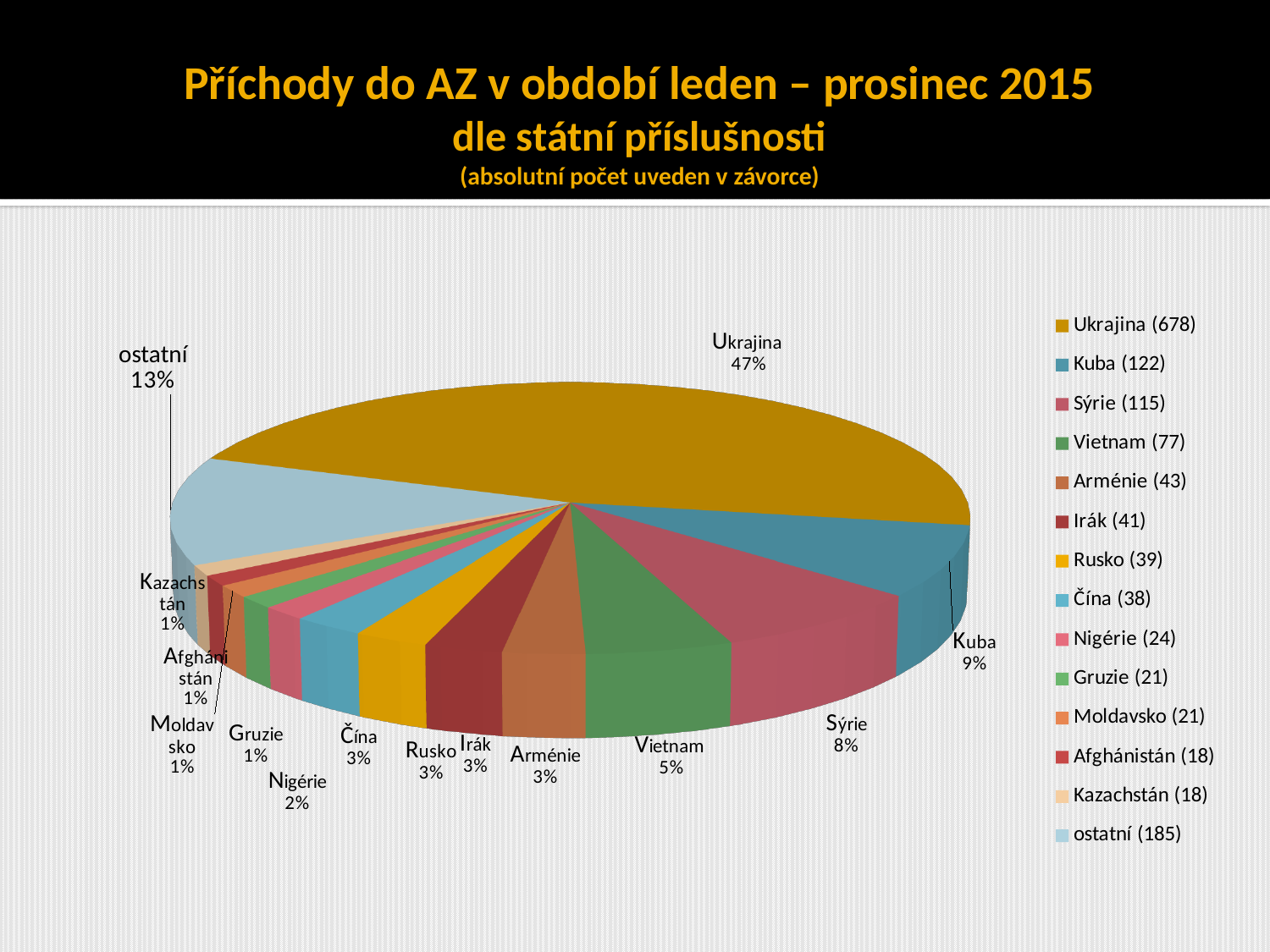
What is the difference in percentage points between the Ukrajina slice (47%) and the Kuba slice (9%)? 38 What percentage is shown for Vietnam? 5% What percentage is shown for the 'ostatní' slice? 13% Which slice is larger, Vietnam or Arménie? Vietnam What is the absolute number shown in the legend for 'ostatní'? 185 According to the legend, what is the absolute number given for Sýrie? 115 Which slice is larger, Kuba or Sýrie? Kuba How many categories (slices) does the pie chart have? 14 What share of the pie does Ukrajina account for? 47% Which category has the largest slice of the pie? Ukrajina What kind of chart is shown on the slide? pie chart What percentage is shown for Kuba? 9%